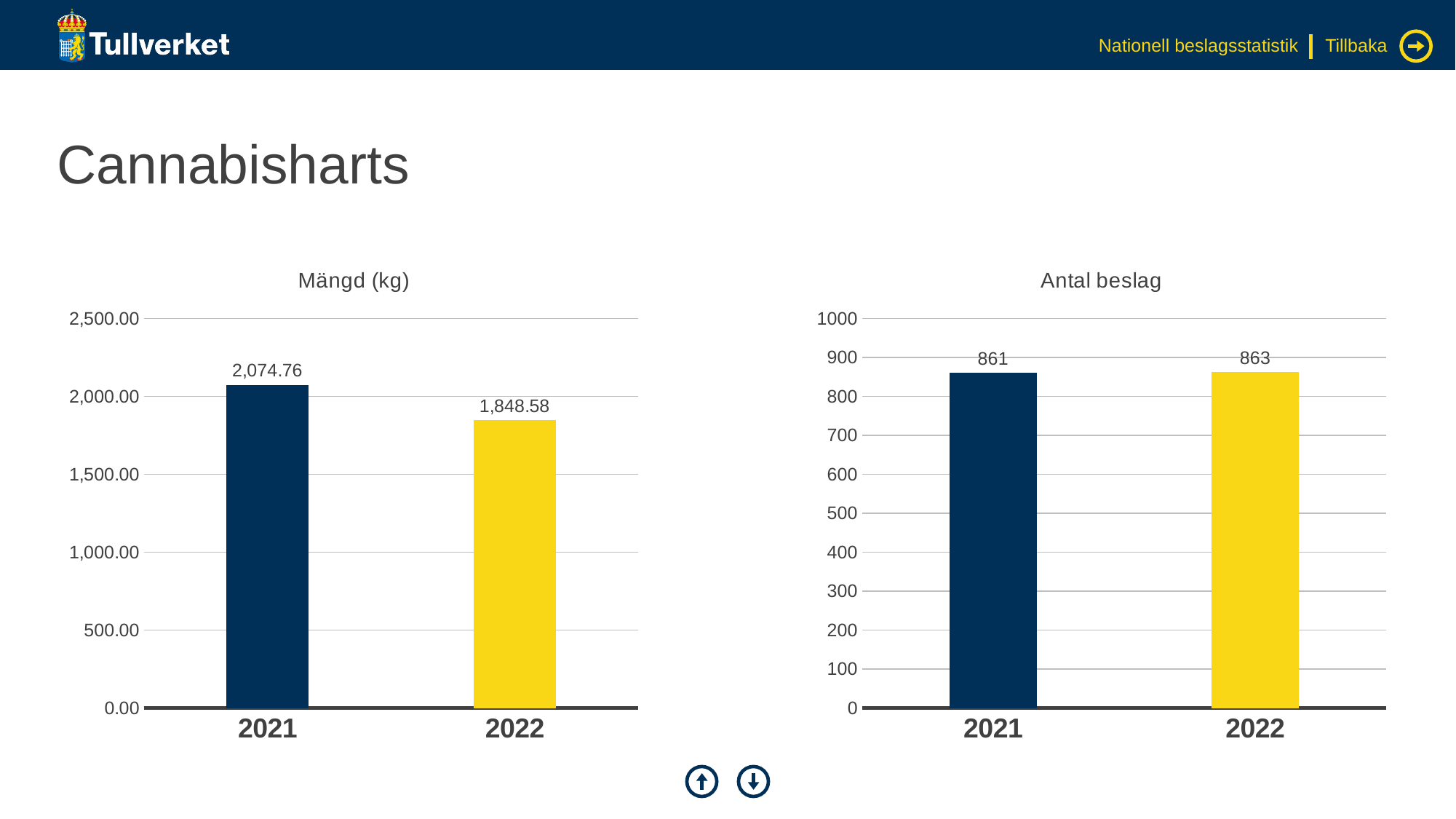
How many categories are shown on the x axis of the 'Antal beslag' chart? 2 In the 'Mängd (kg)' chart, which year has the lowest value? 2022 What kind of chart is the 'Mängd (kg)' chart? bar chart In the 'Mängd (kg)' chart, what is the value for 2021? 2,074.76 In the 'Mängd (kg)' chart, what is the value for 2022? 1,848.58 In the 'Mängd (kg)' chart, is the value for 2022 greater or less than 2,000.00? less In the 'Antal beslag' chart, what is the difference between the 2022 and 2021 values? 2 In the 'Antal beslag' chart, what is the value for 2022? 863 In the 'Antal beslag' chart, what is the value for 2021? 861 In the 'Mängd (kg)' chart, which year has the highest value? 2021 In the 'Mängd (kg)' chart, what is the difference between the 2021 and 2022 values? 226.18 In the 'Antal beslag' chart, is the value for 2021 greater or less than 800? greater